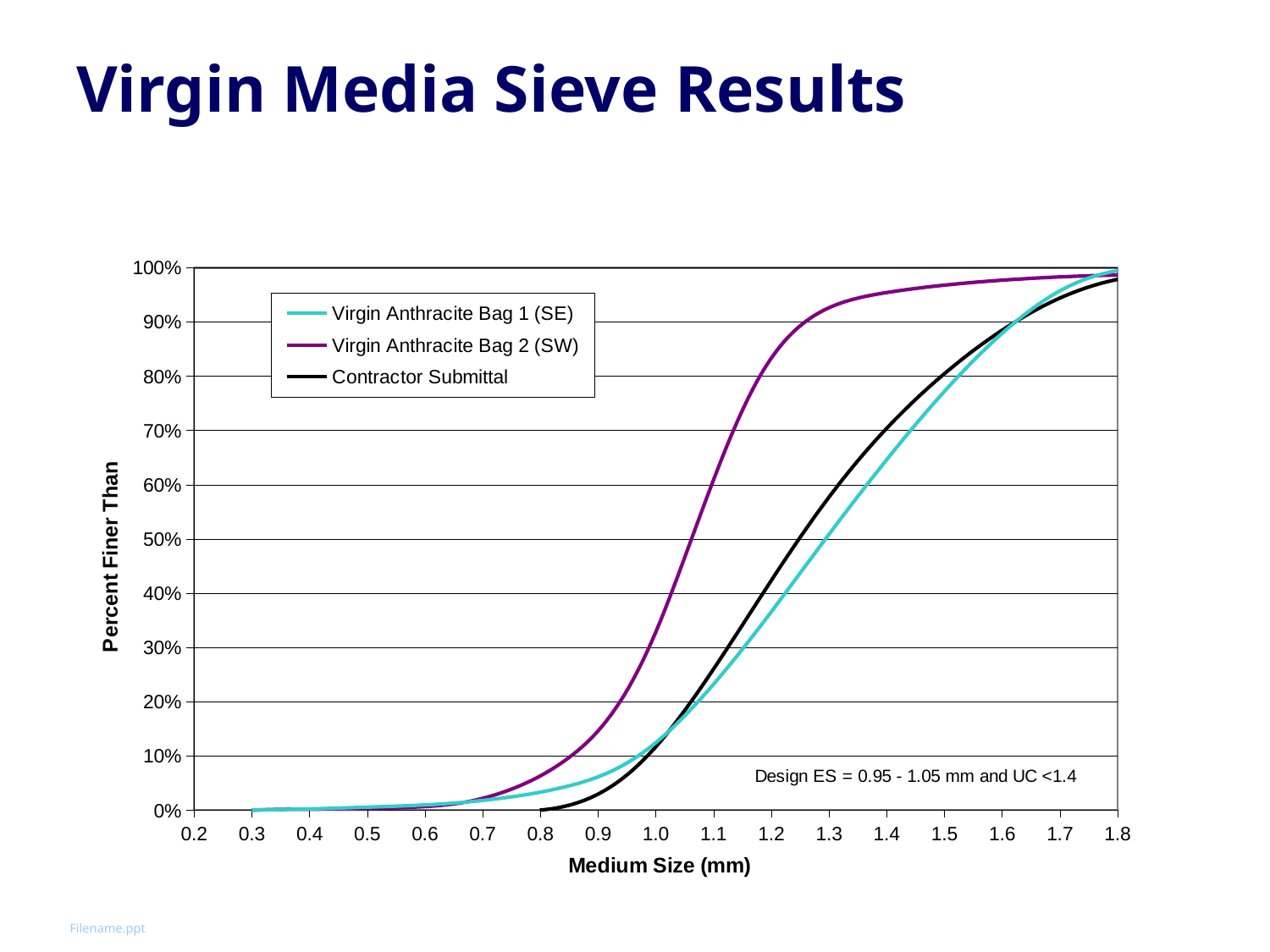
Which series is drawn in black? Contractor Submittal At 1.3 mm, which series has the higher Percent Finer Than: Virgin Anthracite Bag 1 (SE) or Virgin Anthracite Bag 2 (SW)? Virgin Anthracite Bag 2 (SW) Is the value for Virgin Anthracite Bag 2 (SW) at 1.4 mm greater or less than 90%? greater At 1.4 mm, which series has the higher Percent Finer Than: Contractor Submittal or Virgin Anthracite Bag 1 (SE)? Contractor Submittal Is the value for Virgin Anthracite Bag 1 (SE) at 1.6 mm greater or less than 80%? greater How many series does the legend list? 3 At 1.2 mm, which series has the higher Percent Finer Than: Virgin Anthracite Bag 2 (SW) or Contractor Submittal? Virgin Anthracite Bag 2 (SW) Do the values for Virgin Anthracite Bag 2 (SW) rise or fall as Medium Size increases? Rise Is the value for Virgin Anthracite Bag 2 (SW) at 1.0 mm greater or less than 20%? greater What kind of chart is shown on the slide? Line chart What is the label on the y axis? Percent Finer Than